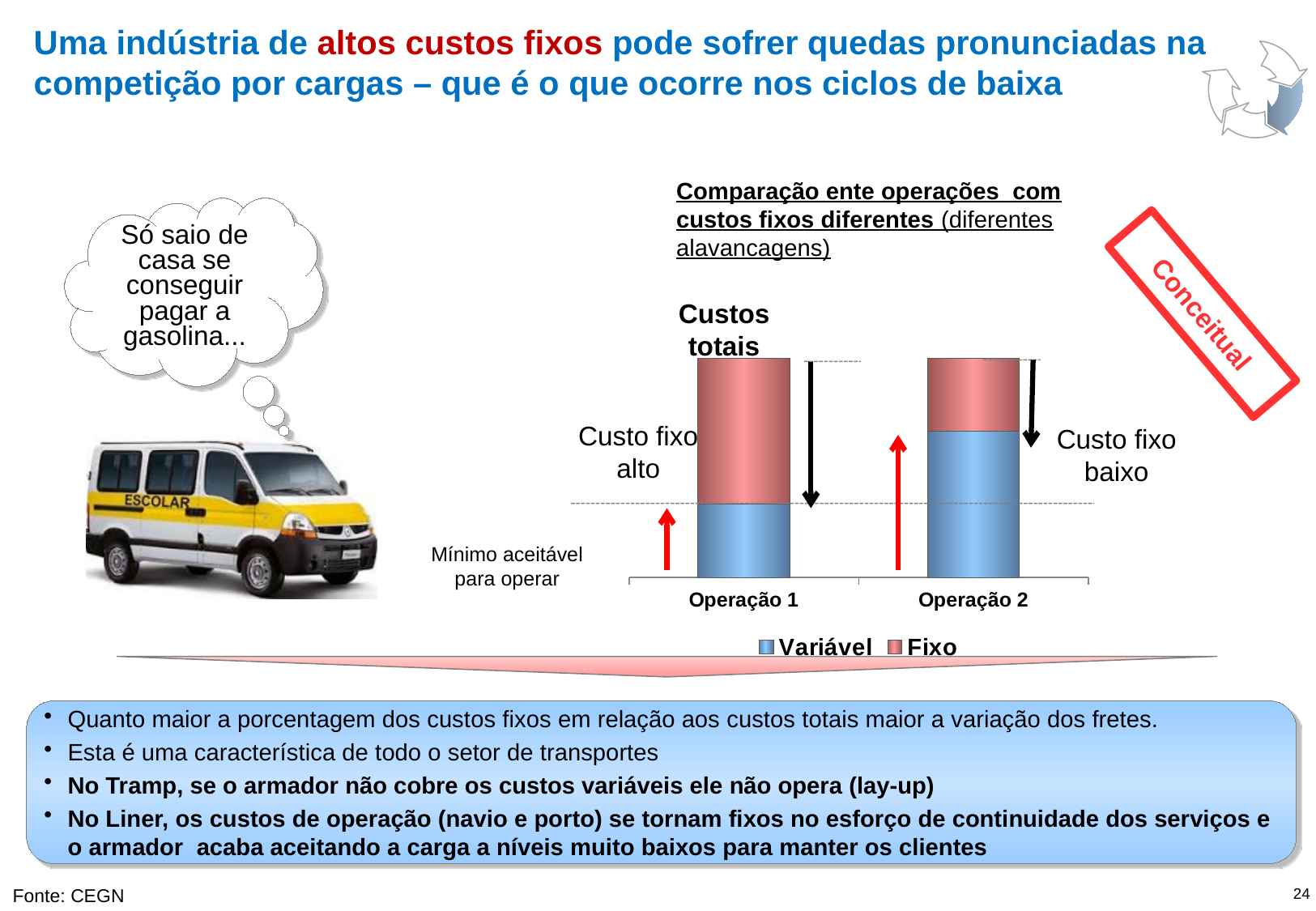
Which category has the lowest 'Variável' value? Operação 1 Which operation is labelled 'Custo fixo baixo' on the chart? Operação 2 What kind of chart is shown on the slide? Stacked bar chart What are the two series listed in the chart legend? Variável and Fixo Which operation has the larger 'Fixo' (red) portion, Operação 1 or Operação 2? Operação 1 Which operation is labelled 'Custo fixo alto' on the chart? Operação 1 Which colour represents the 'Fixo' series in the chart? Red Which operation has the larger 'Variável' (blue) portion, Operação 1 or Operação 2? Operação 2 How many series does the chart legend list? 2 Which category has the highest 'Fixo' value? Operação 1 How many categories are shown on the x axis of the chart? 2 What are the names of the two categories on the x axis? Operação 1 and Operação 2